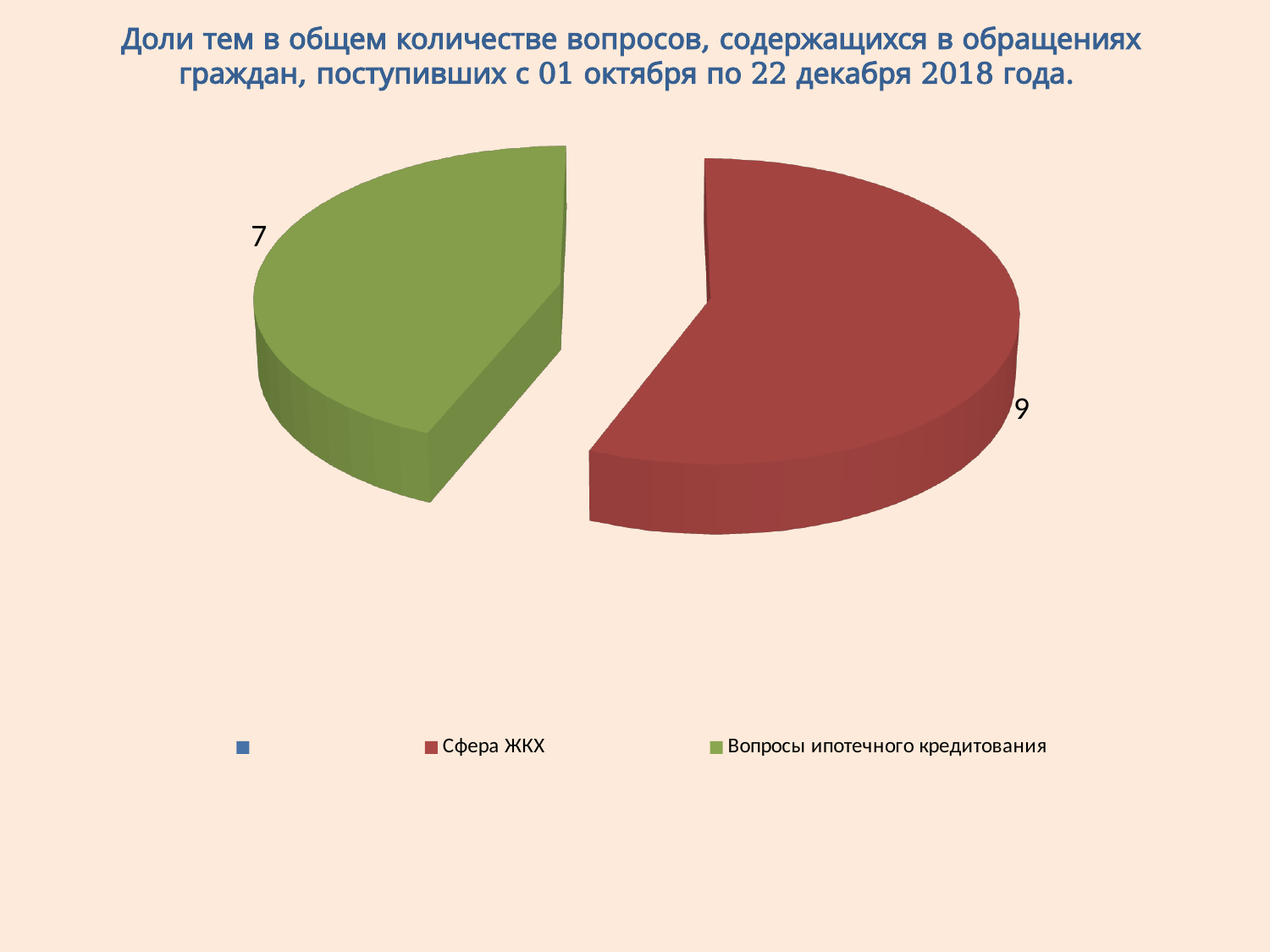
What colour is the slice for Вопросы ипотечного кредитования? green Which category has the smallest slice? Вопросы ипотечного кредитования What is the value for Вопросы ипотечного кредитования? 7 What kind of chart is shown on the slide? pie chart What share of the pie does Сфера ЖКХ represent? 56.25% What is the value for Сфера ЖКХ? 9 Which is larger: the value for Сфера ЖКХ or the value for Вопросы ипотечного кредитования? Сфера ЖКХ What colour is the slice for Сфера ЖКХ? red What is the total of the two labelled slices? 16 How many slices are visible in the pie chart? 2 What is the difference between the values for Сфера ЖКХ and Вопросы ипотечного кредитования? 2 Which category has the largest slice? Сфера ЖКХ